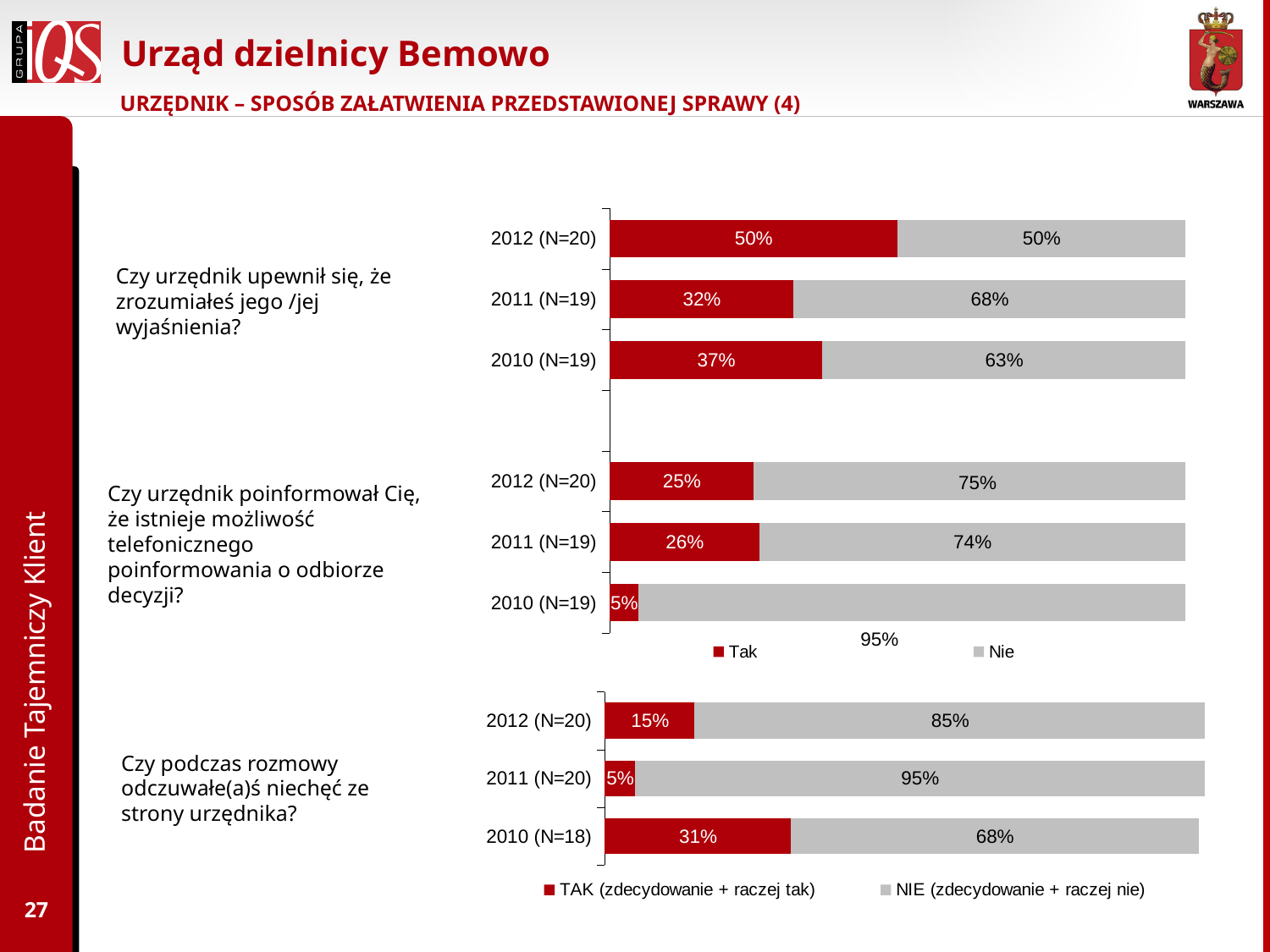
In the upper chart, for the question 'Czy urzędnik upewnił się, że zrozumiałeś jego /jej wyjaśnienia?', what is the 'Tak' value for 2012 (N=20)? 50% In the upper chart, for the question 'Czy urzędnik upewnił się, że zrozumiałeś jego /jej wyjaśnienia?', what is the 'Nie' value for 2011 (N=19)? 68% In the lower chart ('Czy podczas rozmowy odczuwałe(a)ś niechęć ze strony urzędnika?'), what is the 'NIE' value for 2011 (N=20)? 95% In the upper chart, for the question 'Czy urzędnik upewnił się, że zrozumiałeś jego /jej wyjaśnienia?', which year has the lowest 'Tak' value? 2011 (N=19) In the upper chart, for the question 'Czy urzędnik poinformował Cię, że istnieje możliwość telefonicznego poinformowania o odbiorze decyzji?', which year has the highest 'Tak' value? 2011 (N=19) How many series does the legend of the lower chart list? 2 In the upper chart, for the question 'Czy urzędnik poinformował Cię, że istnieje możliwość telefonicznego poinformowania o odbiorze decyzji?', what is the 'Tak' value for 2010 (N=19)? 5% In the lower chart ('Czy podczas rozmowy odczuwałe(a)ś niechęć ze strony urzędnika?'), what is the 'TAK' value for 2010 (N=18)? 31% In the upper chart, for the question 'Czy urzędnik upewnił się, że zrozumiałeś jego /jej wyjaśnienia?', what is the difference between the 'Tak' values for 2012 (N=20) and 2011 (N=19)? 18 percentage points In the lower chart ('Czy podczas rozmowy odczuwałe(a)ś niechęć ze strony urzędnika?'), which year has the highest 'TAK' value? 2010 (N=18) What kind of chart is the lower chart? Stacked bar chart In the lower chart ('Czy podczas rozmowy odczuwałe(a)ś niechęć ze strony urzędnika?'), is the 'TAK' value for 2012 (N=20) larger or smaller than the 'TAK' value for 2010 (N=18)? smaller